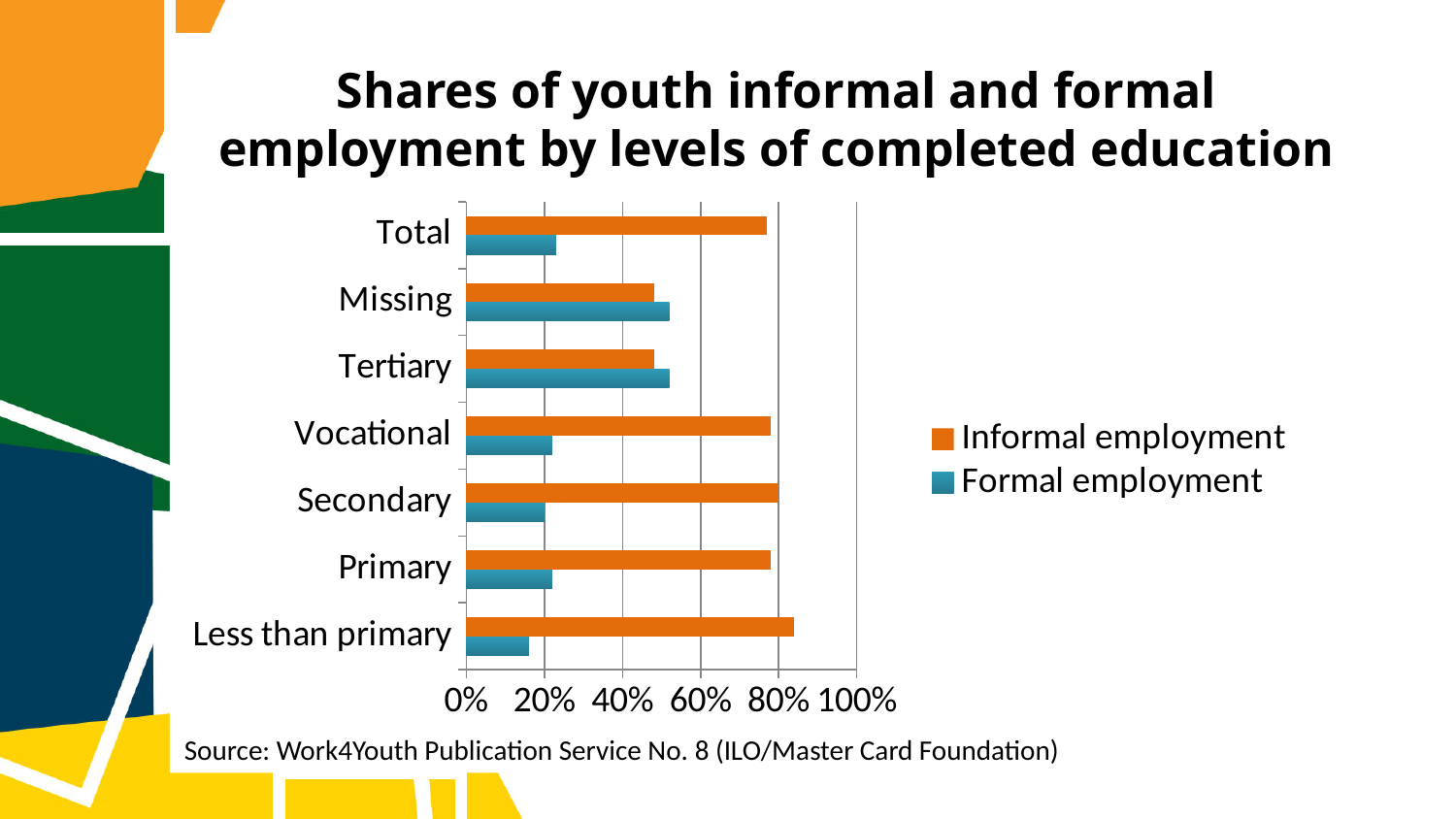
Which series is shown in orange? Informal employment What is the title of the chart? Shares of youth informal and formal employment by levels of completed education Which category has the lowest Formal employment share? Less than primary How many education categories are shown on the chart? 7 Is the Formal employment value for Tertiary greater or less than 40%? greater For Vocational, which is larger: Informal employment or Formal employment? Informal employment Which category has the highest Informal employment share? Less than primary Is the Informal employment value for Total greater or less than 60%? greater How many series does the legend list? 2 Is the Formal employment value for Total greater or less than 40%? less What kind of chart is shown on the slide? bar chart